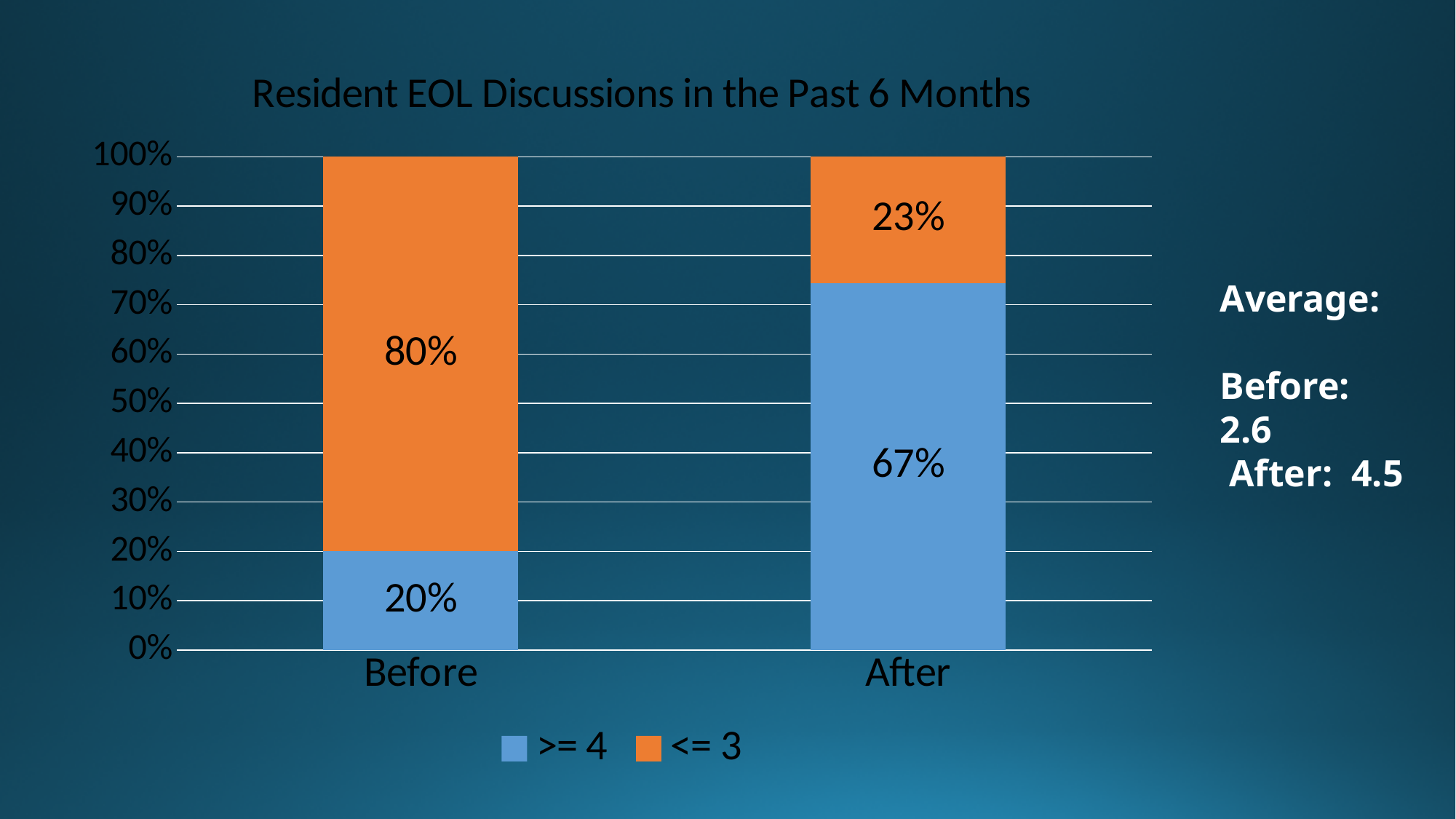
How many series does the legend list? 2 What is the title of the chart? Resident EOL Discussions in the Past 6 Months What is the difference between the ">= 4" values for After and Before? 47% What kind of chart is shown on the slide? Stacked bar chart What is the value for ">= 4" in the After bar? 67% What is the value for "<= 3" in the Before bar? 80% What is the difference between the "<= 3" values for Before and After? 57% Which category has the lower value for "<= 3", Before or After? After What is the value for "<= 3" in the After bar? 23% Which category has the higher value for ">= 4", Before or After? After What is the value for ">= 4" in the Before bar? 20% How many categories are shown on the x axis? 2